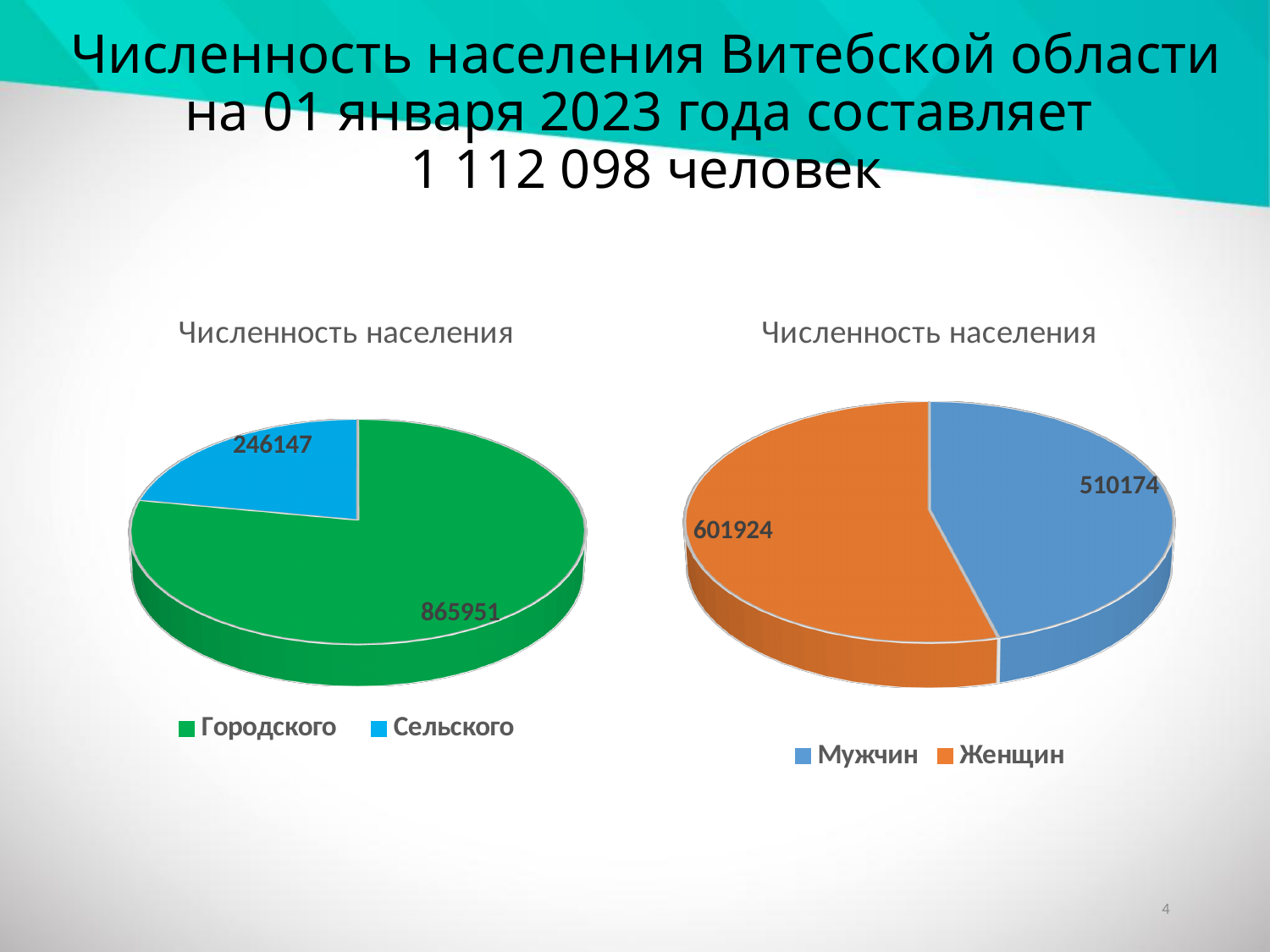
In the right pie chart, what is the difference between Женщин and Мужчин? 91750 In the left pie chart, what is the value for Городского? 865951 In the left pie chart, what is the difference between Городского and Сельского? 619804 What type of chart is the right chart? Pie chart How many slices does the left pie chart have? 2 In the right pie chart, which is larger, Мужчин or Женщин? Женщин In the right pie chart, what is the value for Мужчин? 510174 In the right pie chart, which category has the smallest value? Мужчин In the left pie chart, what share of the total does Сельского represent? 22.1% In the right pie chart, what is the value for Женщин? 601924 In the left pie chart, what is the value for Сельского? 246147 In the left pie chart, which category has the largest value? Городского